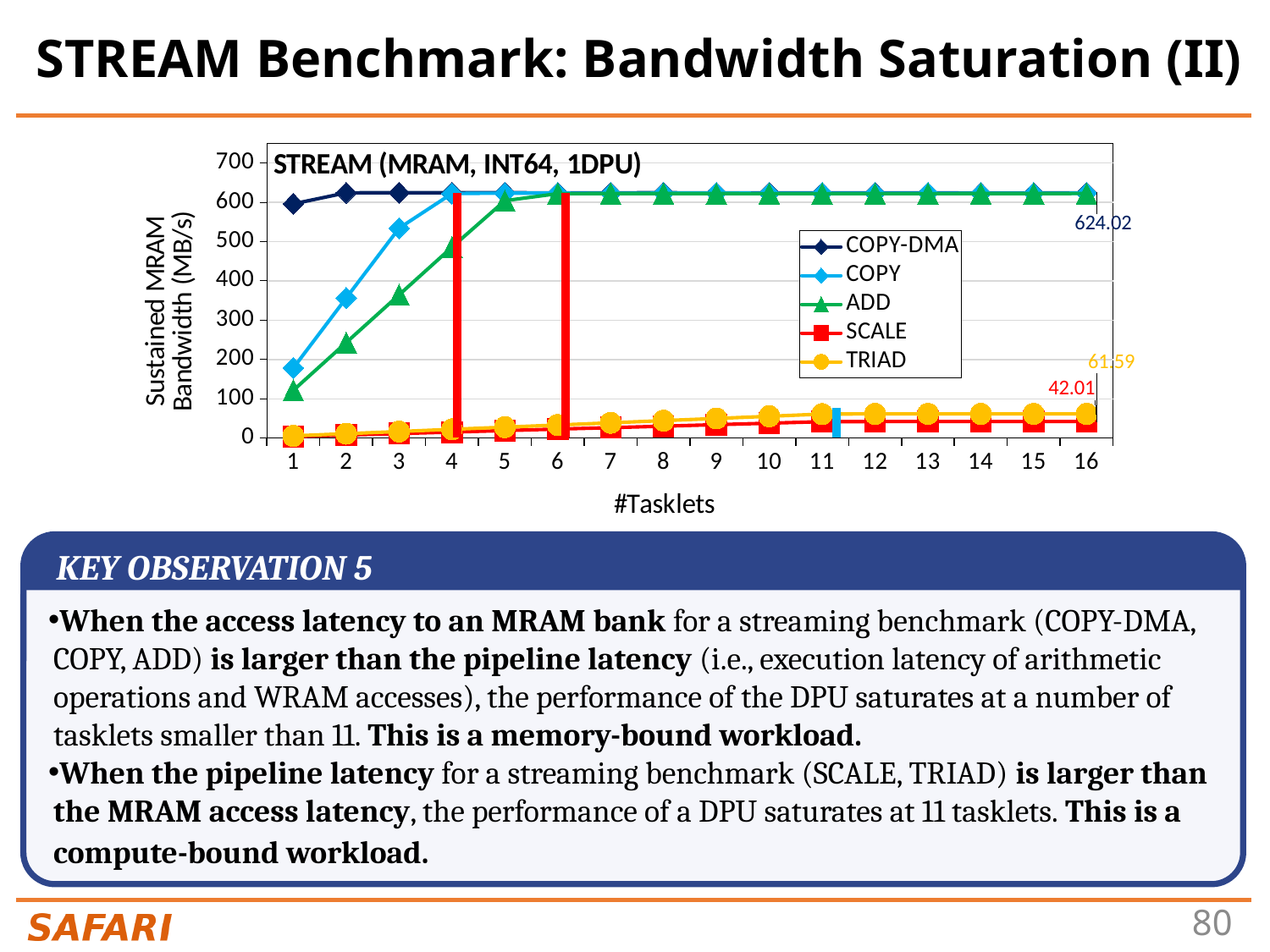
What kind of chart is shown on the slide? line chart What value is labeled for SCALE at 16 tasklets? 42.01 How many tasklet counts are plotted along the x axis of the chart? 16 Is the value for COPY at 1 tasklet greater or less than 200? less At 16 tasklets, which has the larger labeled value, TRIAD or SCALE? TRIAD What value is labeled for COPY-DMA at 16 tasklets? 624.02 Which series has the highest bandwidth at 1 tasklet? COPY-DMA What value is labeled for TRIAD at 16 tasklets? 61.59 How many series does the legend of the chart list? 5 Does the ADD series rise or fall as the number of tasklets increases from 1 to 5? rise What is the title of the x axis of the chart? #Tasklets What is the difference between the labeled TRIAD value (61.59) and the labeled SCALE value (42.01) at 16 tasklets? 19.58